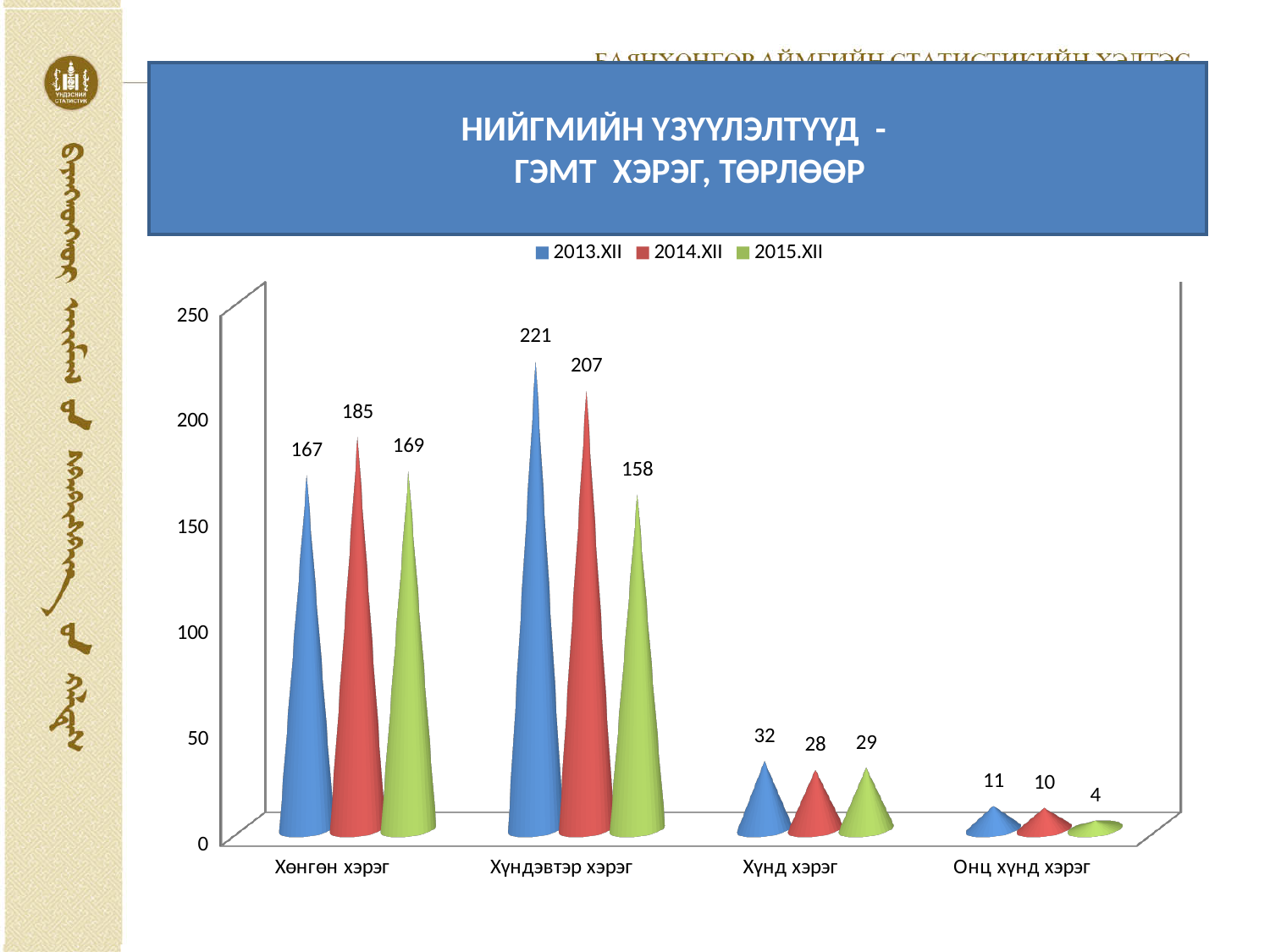
What is the value for Онц хүнд хэрэг in the 2015.XII series? 4 What is the difference between the 2013.XII and 2015.XII values for Хүндэвтэр хэрэг? 63 What is the value for Хүнд хэрэг in the 2013.XII series? 32 What kind of chart is shown on the slide? Bar chart Which category has the highest value in the 2014.XII series? Хүндэвтэр хэрэг Which is larger for Хөнгөн хэрэг: the 2014.XII value or the 2015.XII value? 2014.XII How many categories are shown on the x axis? 4 Which series is shown in red in the legend? 2014.XII Which category has the lowest value in the 2015.XII series? Онц хүнд хэрэг How many series does the legend list? 3 What is the value for Хөнгөн хэрэг in the 2014.XII series? 185 What is the value for Хүндэвтэр хэрэг in the 2013.XII series? 221